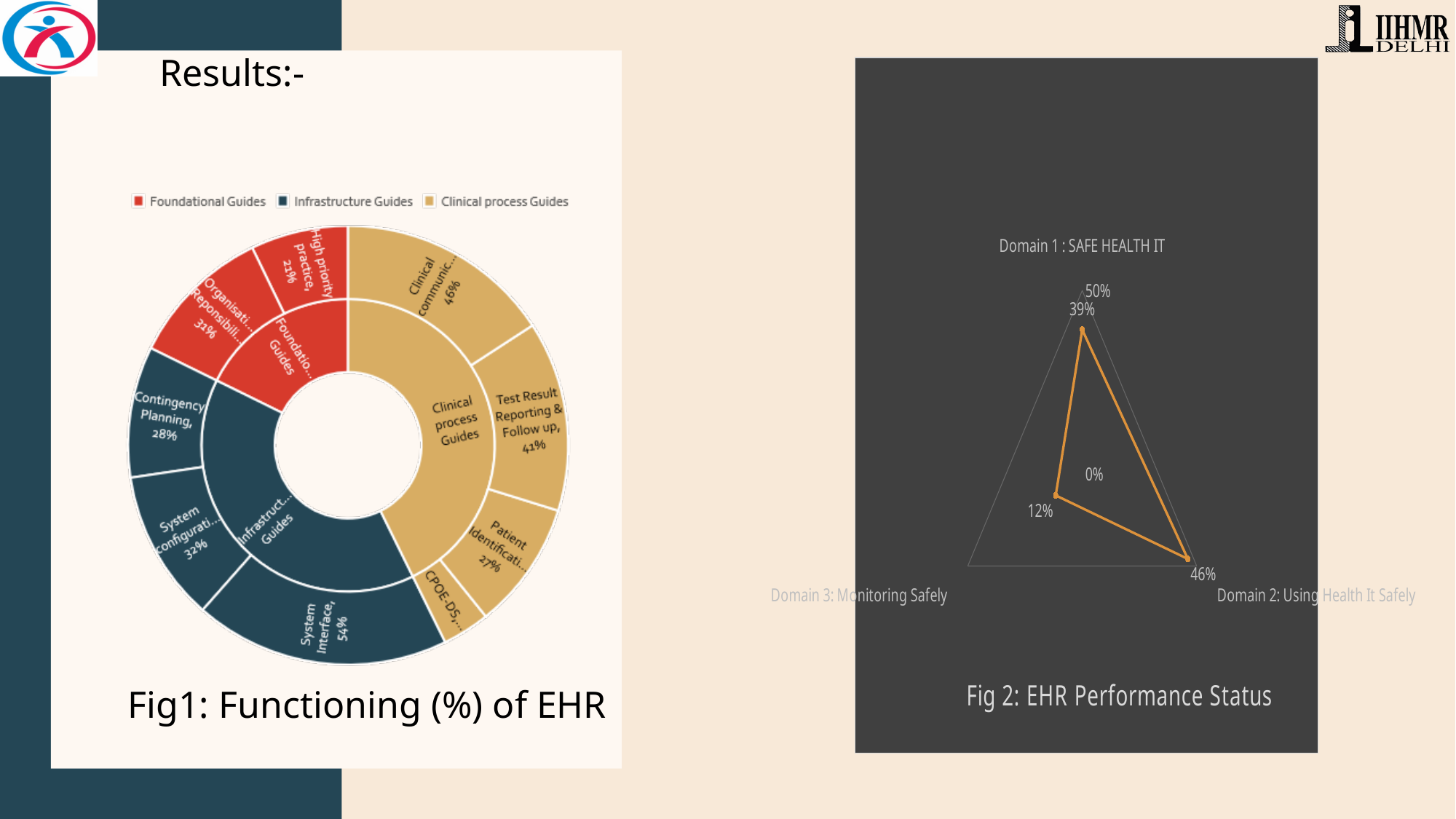
In Fig 2: EHR Performance Status, what is the difference between the values for Domain 2 and Domain 3? 34% In Fig 2: EHR Performance Status, how many domains are plotted? 3 In Fig 1: Functioning (%) of EHR, what is the value for Test Result Reporting & Follow up? 41% In Fig 2: EHR Performance Status, what is the value for Domain 1 : SAFE HEALTH IT? 39% In Fig 2: EHR Performance Status, which domain has the highest value? Domain 2: Using Health It Safely In Fig 1: Functioning (%) of EHR, which is larger, the value for Contingency Planning or the value for System Interface? System Interface In Fig 1: Functioning (%) of EHR, how many series does the legend list? 3 In Fig 1: Functioning (%) of EHR, what is the value for System Interface? 54% In Fig 1: Functioning (%) of EHR, which legend entry is shown in red? Foundational Guides In Fig 2: EHR Performance Status, which domain has the lowest value? Domain 3: Monitoring Safely In Fig 2: EHR Performance Status, what is the value for Domain 3: Monitoring Safely? 12% In Fig 1: Functioning (%) of EHR, what is the value for Contingency Planning? 28%